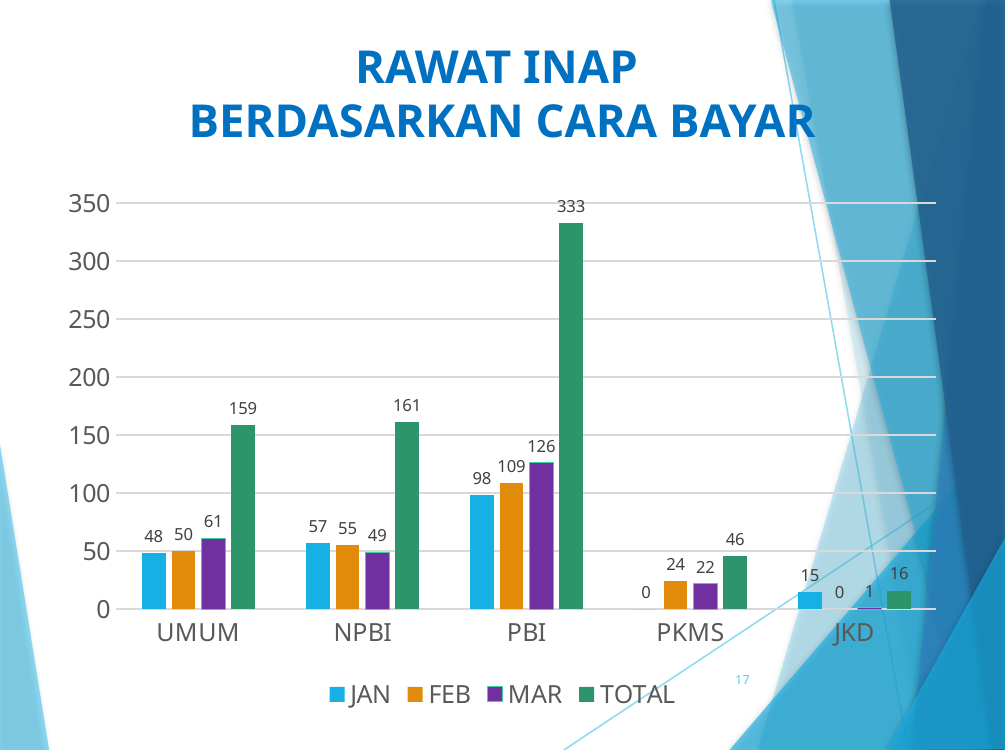
Which is larger, the JAN value for UMUM or the JAN value for NPBI? NPBI What is the title of the chart? RAWAT INAP BERDASARKAN CARA BAYAR What is the TOTAL value for PBI? 333 What is the FEB value for PKMS? 24 How many categories are shown on the x axis? 5 Which category has the highest TOTAL value? PBI What kind of chart is shown on the slide? Bar chart Which category has the lowest TOTAL value? JKD How many series does the legend list? 4 What is the JAN value for JKD? 15 What is the difference between the TOTAL values for NPBI and UMUM? 2 What is the MAR value for NPBI? 49